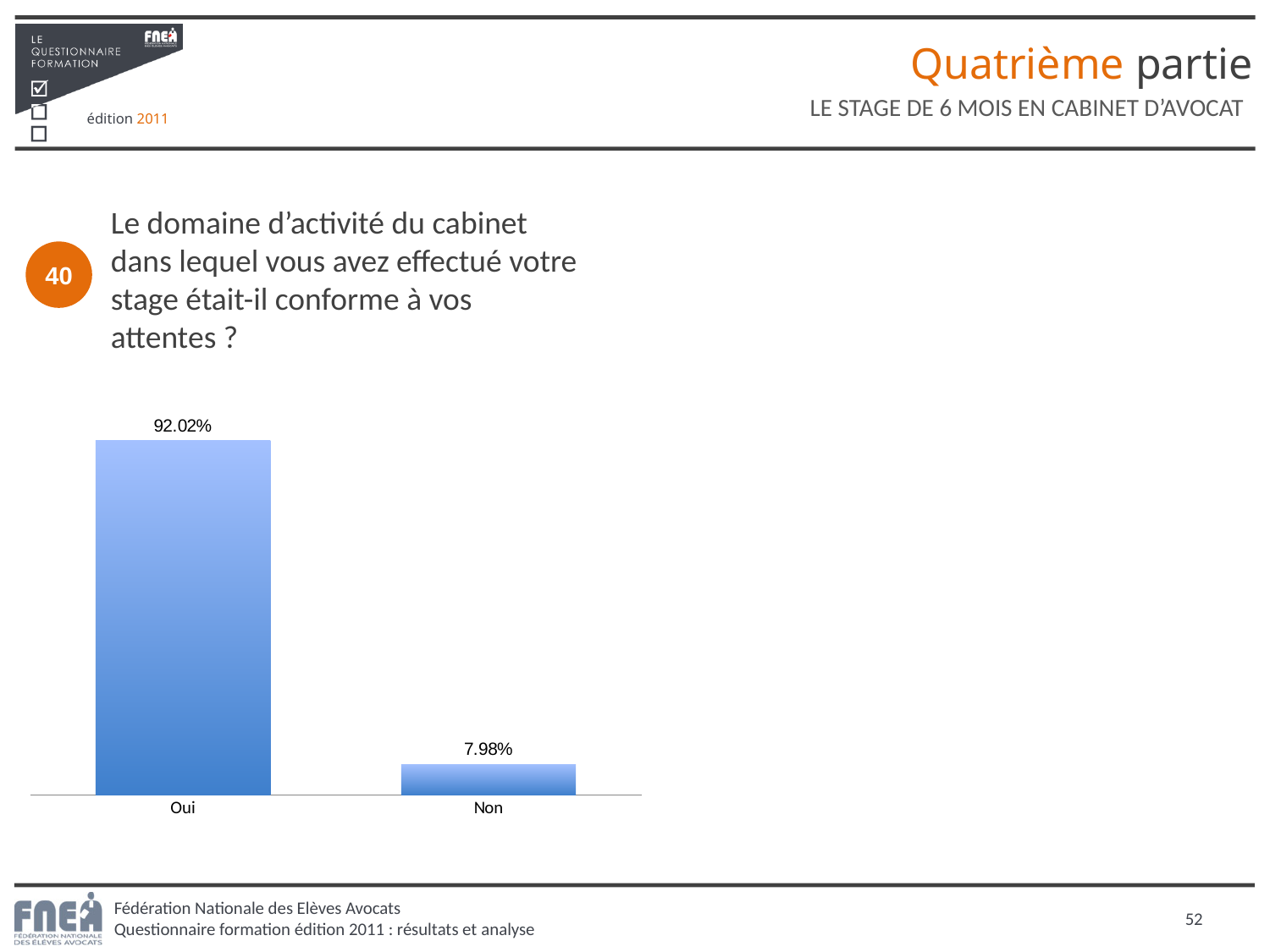
What is the difference between the values for Oui and Non? 84.04% Which category has the lowest value? Non What are the category labels on the x axis of the chart? Oui, Non What is the number of the survey question shown next to the chart? 40 What kind of chart is shown on the slide? Bar chart How many categories are shown in the chart? 2 Which is larger, the value for Oui or the value for Non? Oui What is the value for Non? 7.98% Which category has the highest value? Oui What is the total of the two values shown in the chart? 100% What is the value for Oui? 92.02%